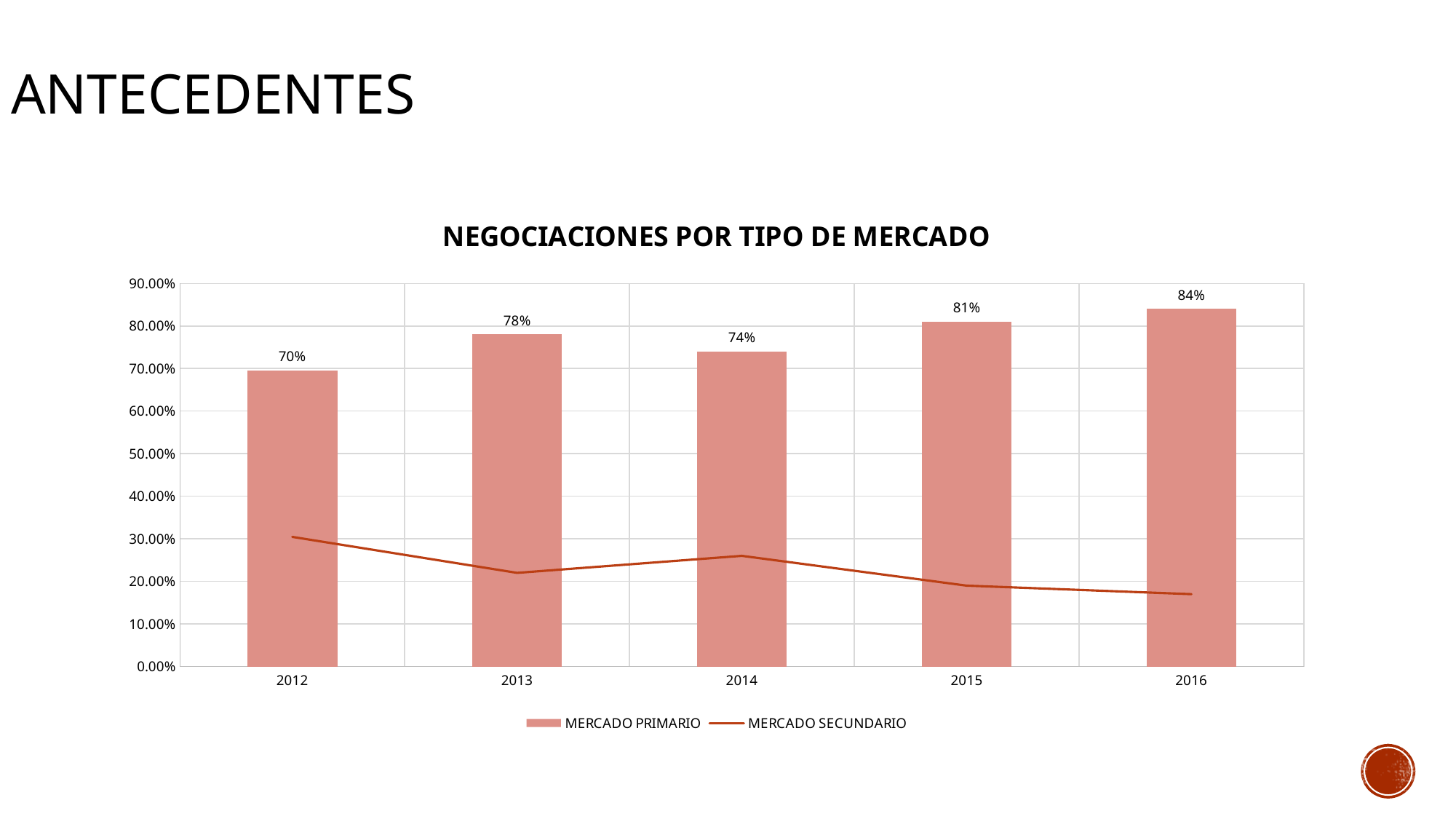
Which is larger for MERCADO PRIMARIO, 2013 or 2014? 2013 Is the value for MERCADO SECUNDARIO in 2012 greater or less than 20.00%? greater What is the value for MERCADO PRIMARIO in 2013? 78% Which year has the highest value for MERCADO PRIMARIO? 2016 Does the MERCADO SECUNDARIO line generally rise or fall from 2012 to 2016? Fall Which year has the lowest value for MERCADO PRIMARIO? 2012 What kind of chart is used for the MERCADO PRIMARIO series? Bar chart How many series does the legend list? 2 What is the difference between the MERCADO PRIMARIO values for 2016 and 2012? 14% How many years are shown on the x axis? 5 What is the value for MERCADO PRIMARIO in 2016? 84% Is the value for MERCADO SECUNDARIO in 2016 greater or less than 20.00%? less